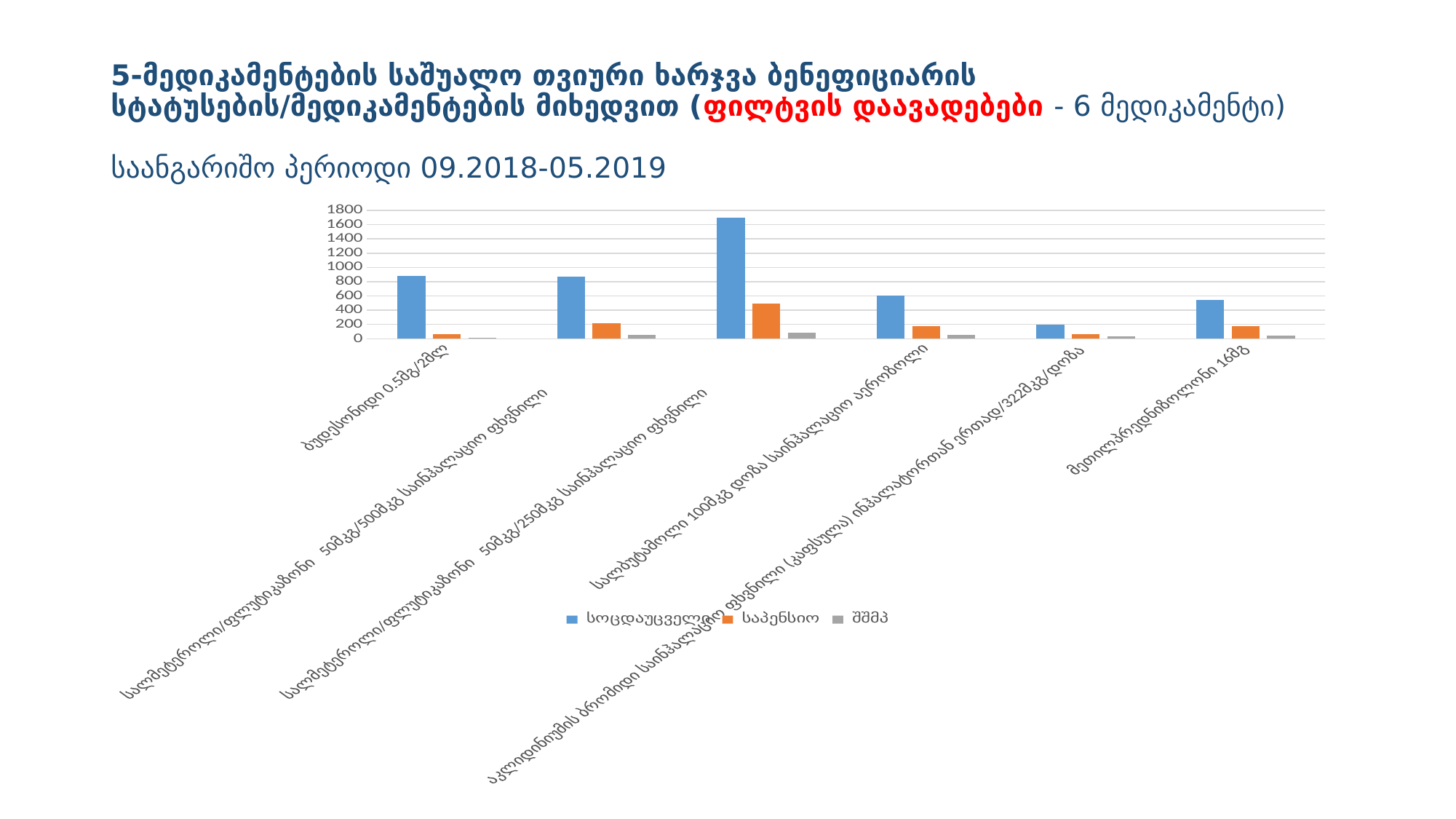
Is the სოციალურად დაუცველი value for აკლიდინიუმის ბრომიდი საინჰალაციო ფხვნილი greater or less than 400? less Which medication has the highest value for the სოციალურად დაუცველი series? სალმეტეროლი/ფლუტიკაზონი 50მკგ/250მკგ საინჰალაციო ფხვნილი What kind of chart is shown on the slide? bar chart Which medication has the lowest value for the სოციალურად დაუცველი series? აკლიდინიუმის ბრომიდი საინჰალაციო ფხვნილი (კაფსულა) ინჰალატორთან ერთად/322მკგ/დოზა How many series does the chart legend list? 3 Which medication has the lowest value for the შშმპ series? ბუდესონიდი 0.5მგ/2მლ Which medication has the highest value for the საპენსიო series? სალმეტეროლი/ფლუტიკაზონი 50მკგ/250მკგ საინჰალაციო ფხვნილი For the საპენსიო series, which is larger: the value for ბუდესონიდი 0.5მგ/2მლ or for სალმეტეროლი/ფლუტიკაზონი 50მკგ/500მკგ საინჰალაციო ფხვნილი? სალმეტეროლი/ფლუტიკაზონი 50მკგ/500მკგ საინჰალაციო ფხვნილი Is the საპენსიო value for სალბუტამოლი 100მკგ დოზა საინჰალაციო აეროზოლი greater or less than 600? less Which series is shown in blue in the chart legend? სოცდაუცველი How many medication categories are shown on the x axis of the chart? 6 Is the სოციალურად დაუცველი value for სალბუტამოლი 100მკგ დოზა საინჰალაციო აეროზოლი greater or less than 1400? less